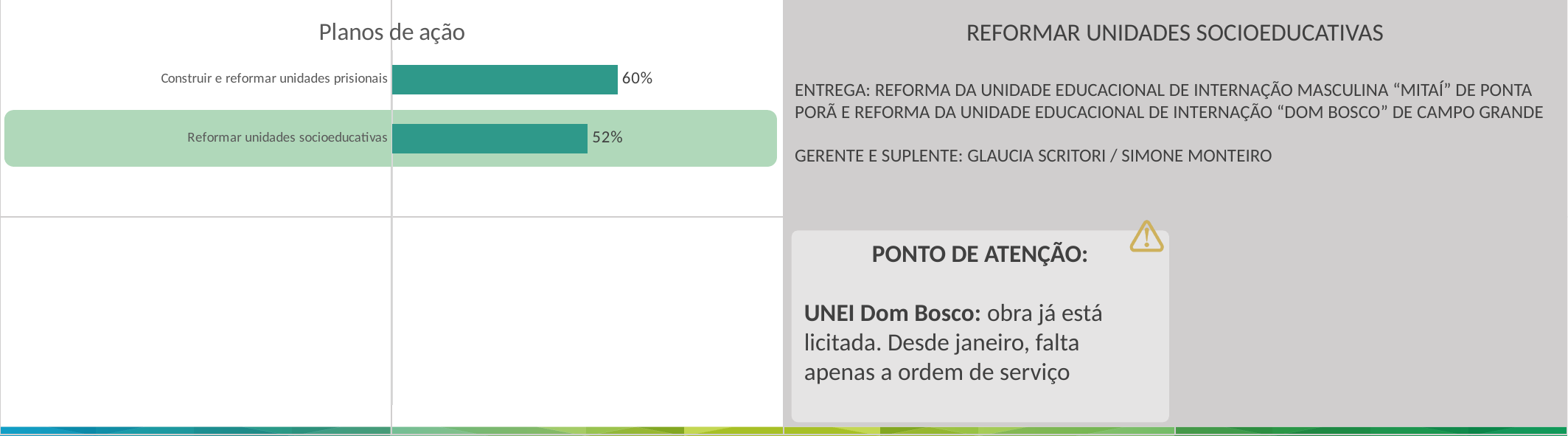
How many categories are shown in the 'Planos de ação' chart? 2 Which category in the 'Planos de ação' chart is highlighted with a green background? Reformar unidades socioeducativas What kind of chart is the 'Planos de ação' chart? Bar chart Which category has the lowest value in the 'Planos de ação' chart? Reformar unidades socioeducativas Which category has the highest value in the 'Planos de ação' chart? Construir e reformar unidades prisionais What is the value for 'Reformar unidades socioeducativas' in the 'Planos de ação' chart? 52% What is the difference between the values for 'Construir e reformar unidades prisionais' and 'Reformar unidades socioeducativas' in the 'Planos de ação' chart? 8% In the 'Planos de ação' chart, which is larger: 'Construir e reformar unidades prisionais' or 'Reformar unidades socioeducativas'? Construir e reformar unidades prisionais What is the title of the chart on the left of the slide? Planos de ação What is the value for 'Construir e reformar unidades prisionais' in the 'Planos de ação' chart? 60%